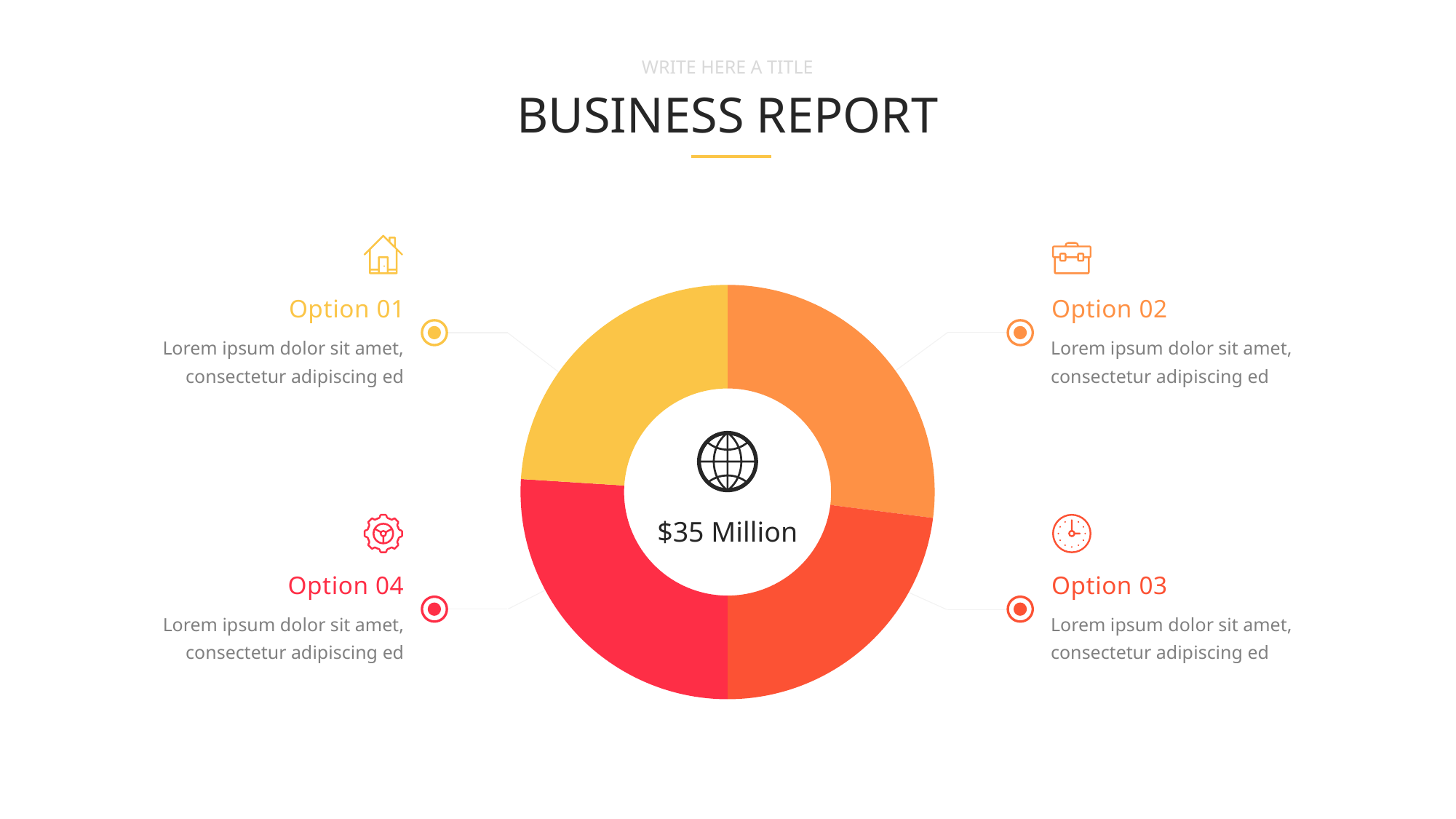
What value is printed in the centre of the donut chart? $35 Million What colour is the Option 01 segment of the donut chart? Yellow What is the title of the slide containing the chart? BUSINESS REPORT What kind of chart is shown on the slide? Pie chart (donut) How many segments does the donut chart have? 4 Which segment is larger, Option 02 or Option 03? Option 02